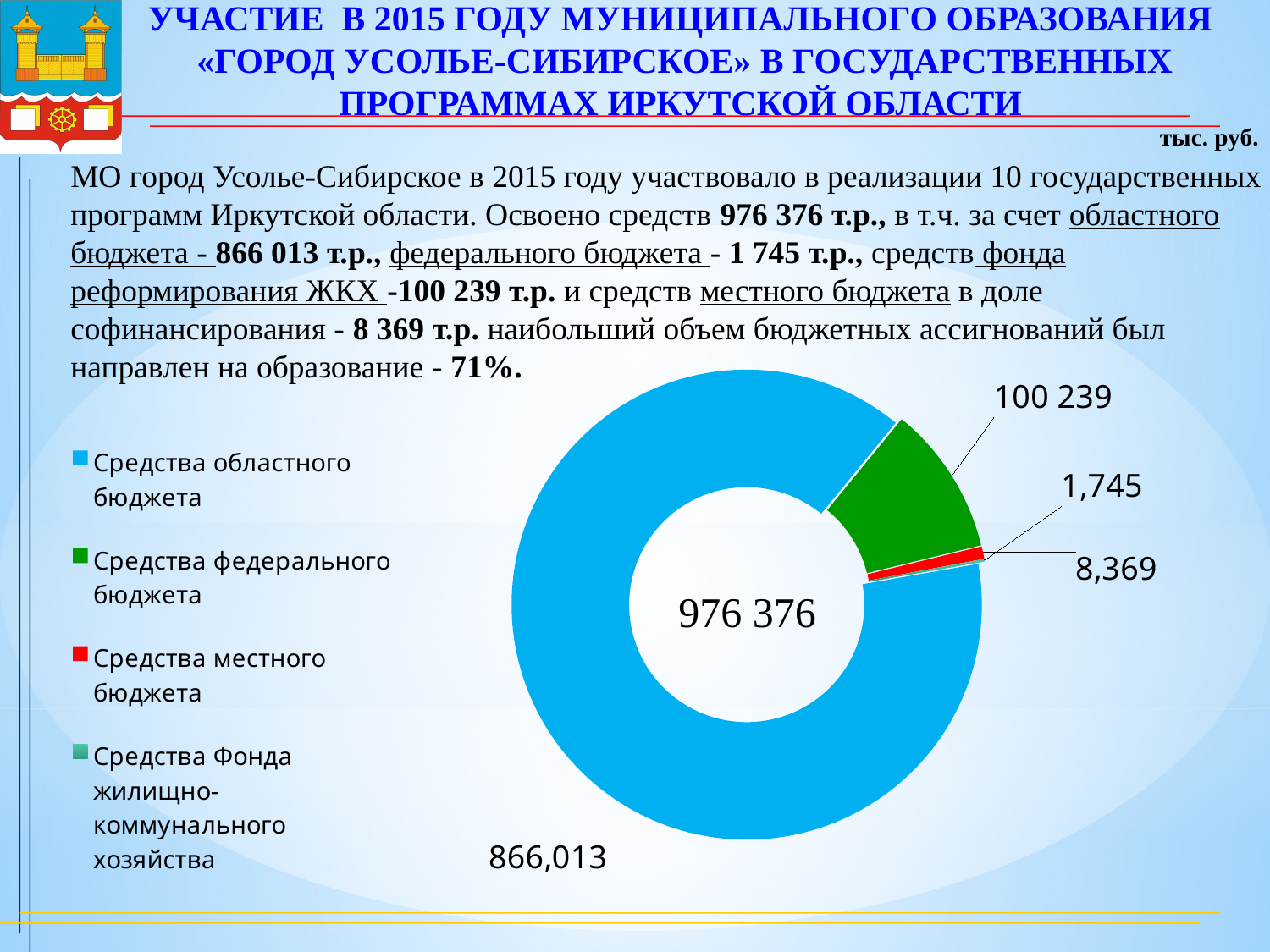
What is the difference between the slice labelled 866,013 and the slice labelled 100 239? 765,774 What is the value shown for the slice labelled 'Средства областного бюджета' (blue)? 866,013 How many entries does the chart legend list? 4 Which is larger: the slice labelled 100 239 or the slice labelled 8,369? 100 239 What is the value of the largest slice in the doughnut chart? 866,013 What is the difference between the slice labelled 8,369 and the slice labelled 1,745? 6,624 How many slices does the doughnut chart have? 4 What colour is the largest slice of the doughnut chart? Blue What is the value shown for the red slice ('Средства местного бюджета')? 8,369 What is the value of the smallest slice in the doughnut chart? 1,745 What value is printed in the centre of the doughnut chart? 976 376 What kind of chart is shown on the slide? Doughnut (pie) chart